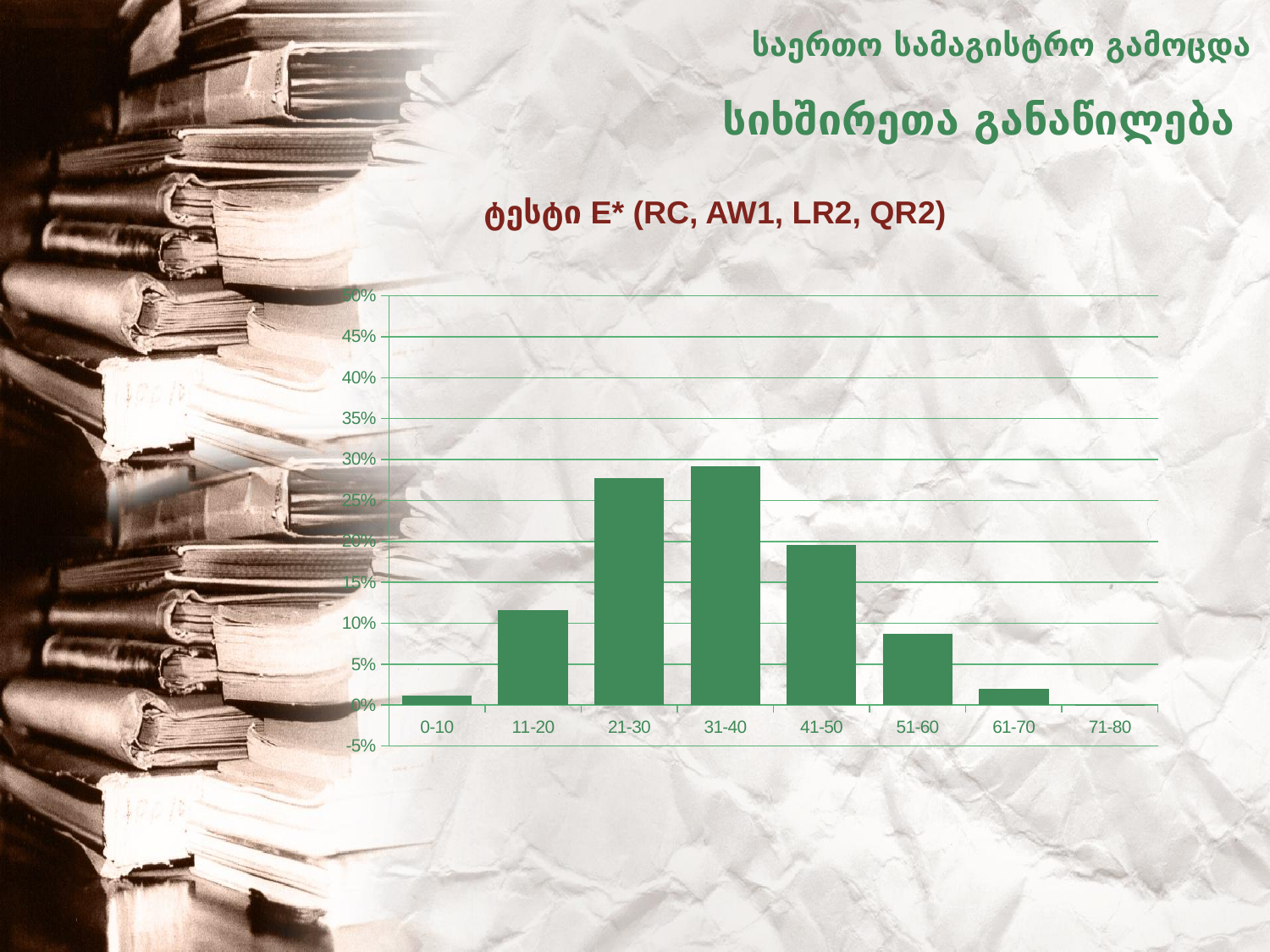
Which is larger, the value for 21-30 or the value for 41-50? 21-30 Which is larger, the value for 11-20 or the value for 51-60? 11-20 What kind of chart is shown on the slide? bar chart Is the value for 21-30 greater or less than 25%? greater Is the value for 61-70 greater or less than 5%? less Is the value for 41-50 greater or less than 15%? greater How many score-range categories are shown on the x axis? 8 Do the values rise or fall from 41-50 to 71-80? fall Which category has the lowest value? 71-80 What is the title of the chart? ტესტი E* (RC, AW1, LR2, QR2)